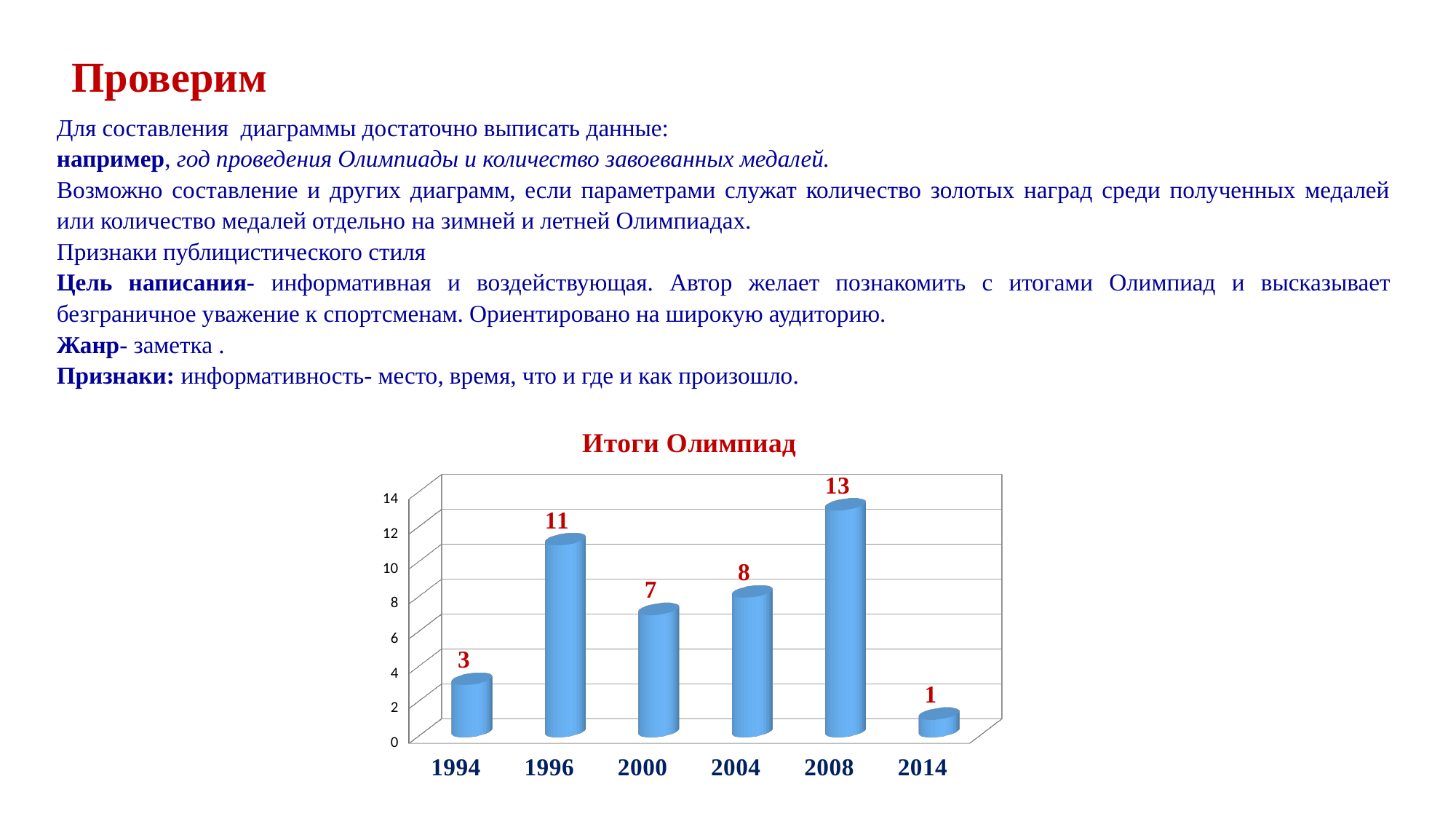
What is the title of the chart? Итоги Олимпиад What is the value for 2004 in the chart? 8 How many years are shown on the x axis of the chart? 6 What is the value for 2014 in the chart? 1 Which year has the highest value in the chart? 2008 What kind of chart is shown on the slide? bar chart Which is larger, the value for 2000 or the value for 2004? 2004 What is the difference between the values for 2008 and 1994? 10 Is the value for 1996 greater or less than 10? greater What is the value for 1996 in the chart? 11 What is the difference between the values for 1996 and 2000? 4 Which year has the lowest value in the chart? 2014